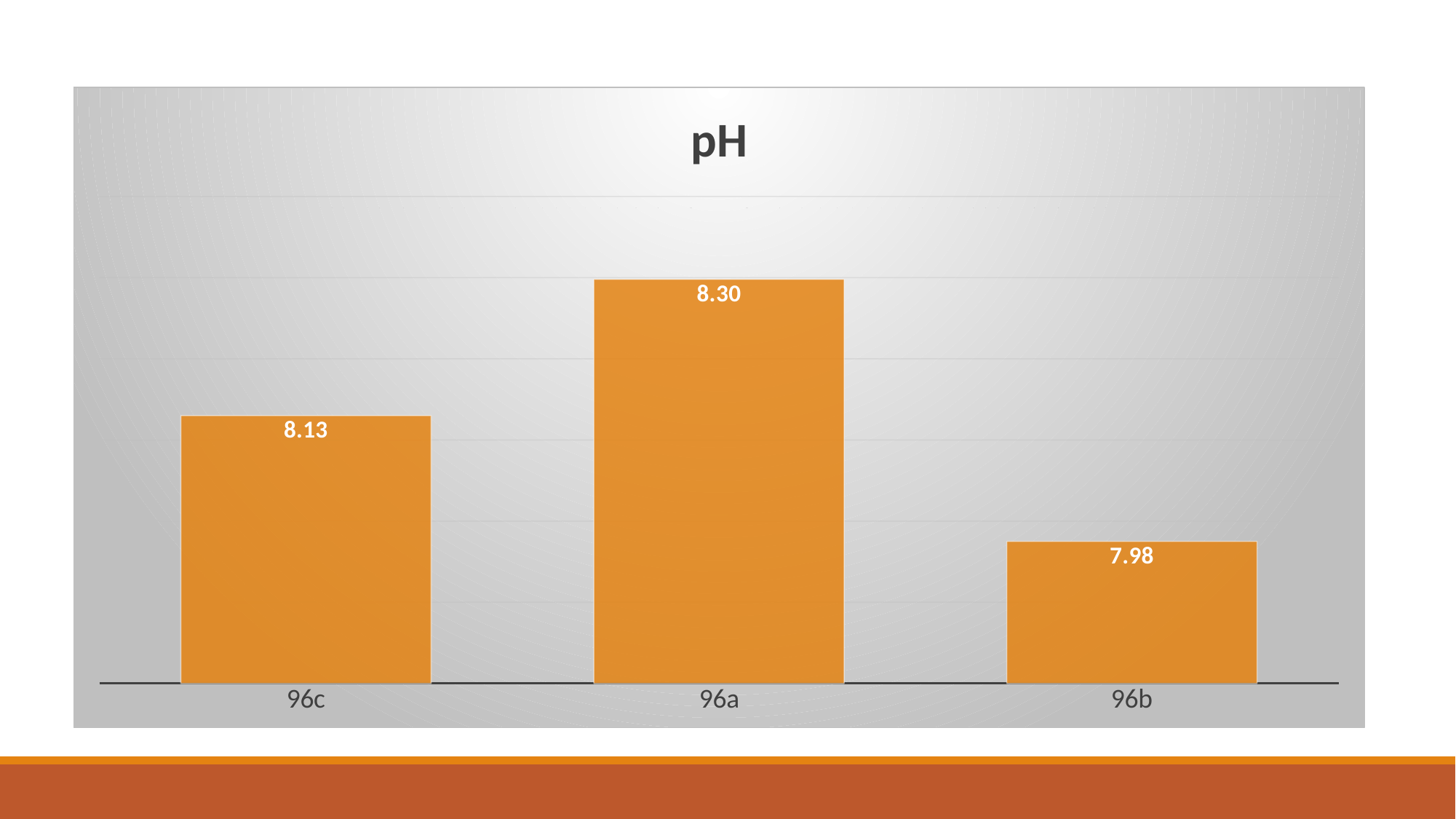
What colour are the bars in the chart? Orange What kind of chart is shown on the slide? Bar chart Which has a higher pH, 96c or 96b? 96c What is the title of the chart? pH Which category has the lowest pH? 96b What is the difference in pH between 96a and 96b? 0.32 What is the pH value for 96a? 8.30 What is the pH value for 96c? 8.13 How many categories are shown in the chart? 3 What is the pH value for 96b? 7.98 What is the difference in pH between 96a and 96c? 0.17 Which category has the highest pH? 96a